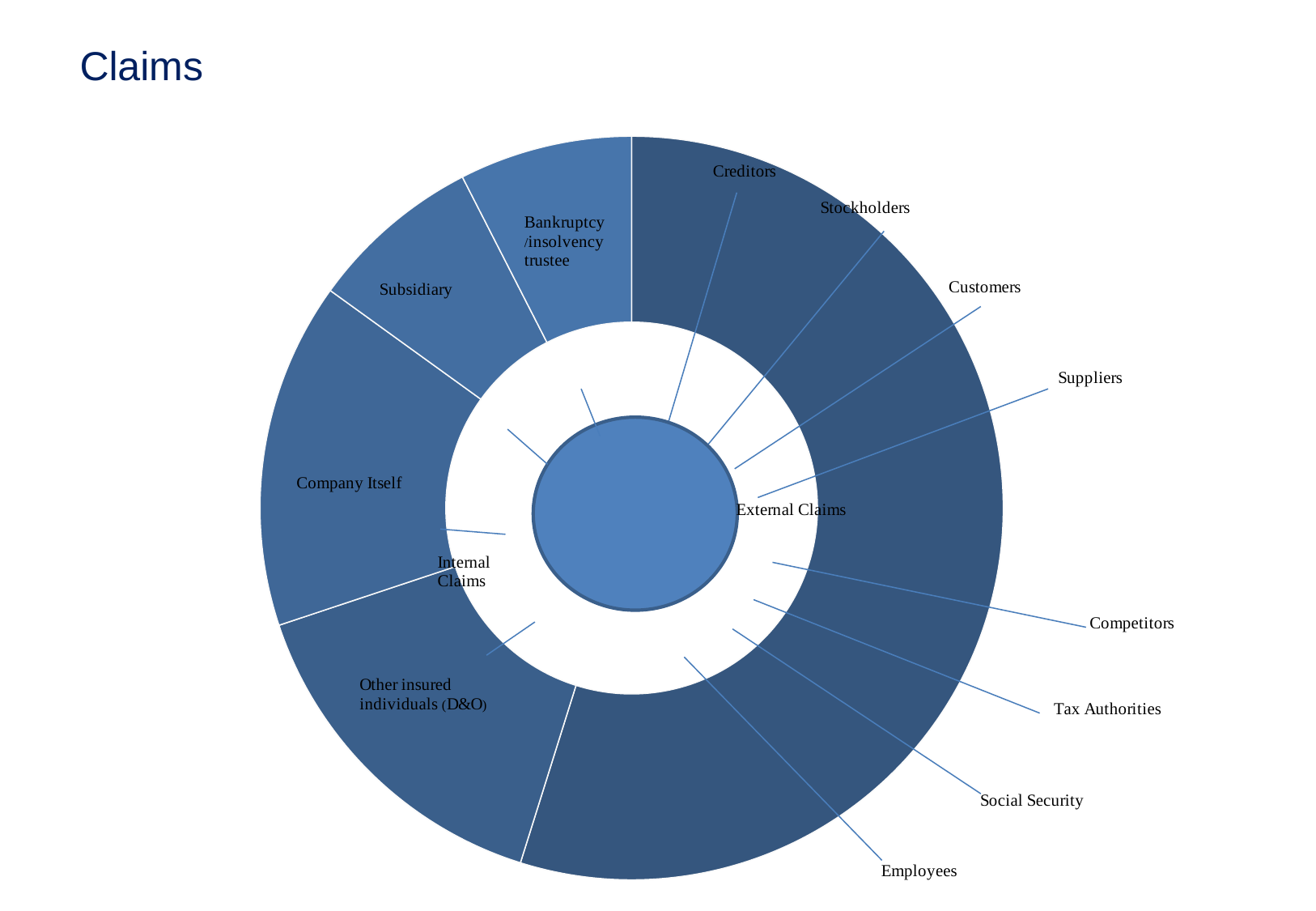
What is the title of the slide containing the chart? Claims What kind of chart is shown on the slide? doughnut chart Which segment is larger, Other insured individuals (D&O) or Bankruptcy/insolvency trustee? Other insured individuals (D&O) Which two categories are labelled in the centre of the chart? Internal Claims and External Claims How many internal claim categories are labelled on the left side of the outer ring? 4 Which segment is larger, Company Itself or Bankruptcy/insolvency trustee? Company Itself Which segment is larger, Other insured individuals (D&O) or Subsidiary? Other insured individuals (D&O) How many external claim sources are labelled on the right side of the chart? 8